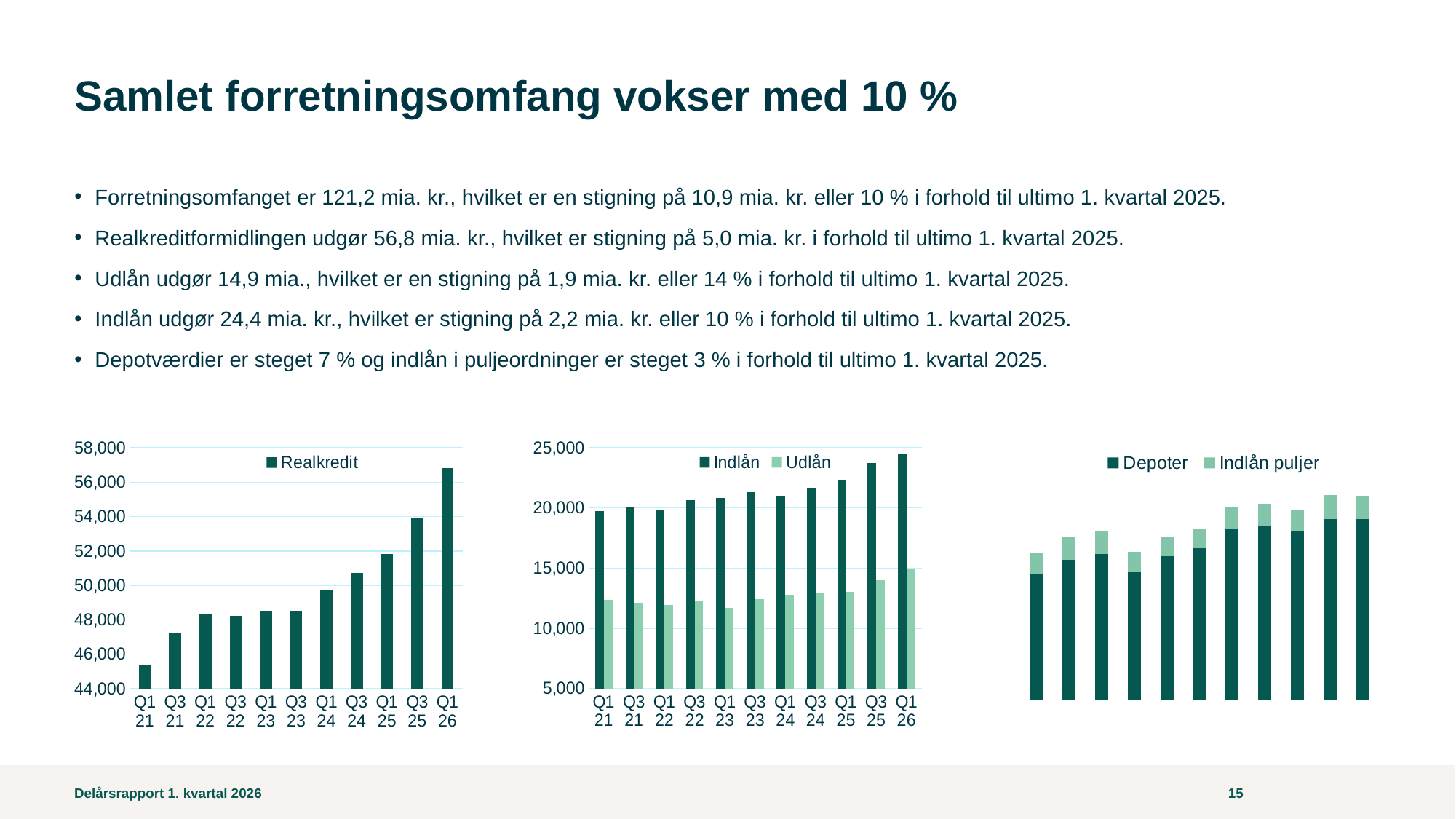
In the left chart (Realkredit), how many quarters are shown on the x axis? 11 What kind of chart is the left chart (Realkredit)? bar chart In the left chart (Realkredit), is the value for Q1 21 greater or less than 46,000? less How many series does the legend of the middle chart list? 2 In the middle chart, which quarter has the highest Indlån value? Q1 26 In the left chart (Realkredit), is the value for Q1 26 greater or less than 56,000? greater In the left chart (Realkredit), which quarter has the highest value? Q1 26 In the left chart (Realkredit), which quarter has the lowest value? Q1 21 In the left chart (Realkredit), do the values generally rise or fall from Q1 21 to Q1 26? rise What are the two series listed in the legend of the right chart? Depoter and Indlån puljer In the middle chart, which is larger in Q1 26, Indlån or Udlån? Indlån